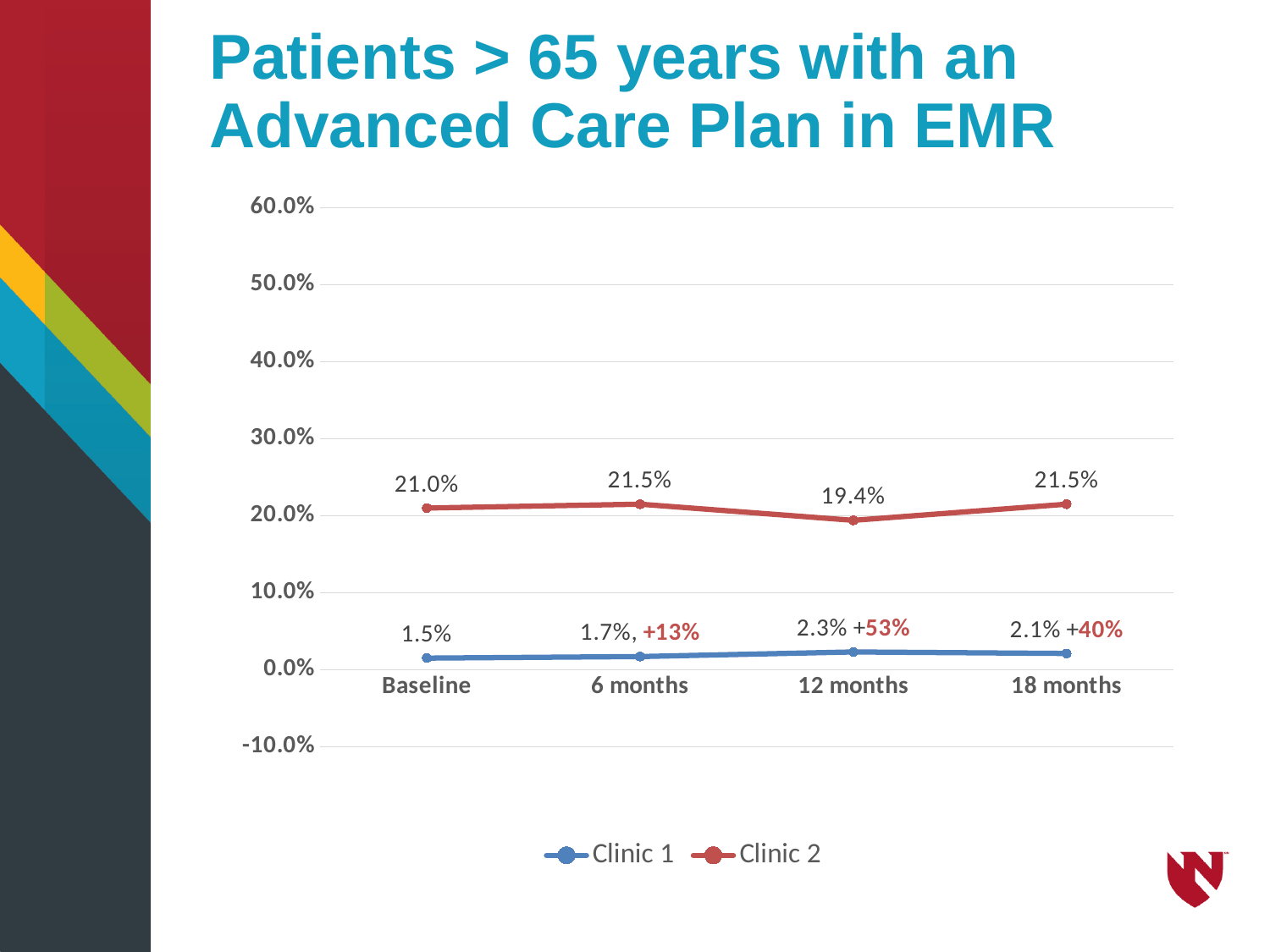
What is the value for Clinic 1 at 18 months? 2.1% What is the value for Clinic 1 at 12 months? 2.3% What is the value for Clinic 2 at 12 months? 19.4% How many time points are shown on the x axis? 4 At which time point is Clinic 2 lowest? 12 months Which is larger at 6 months, Clinic 1 or Clinic 2? Clinic 2 What is the value for Clinic 2 at Baseline? 21.0% At which time point is Clinic 1 highest? 12 months Is the value for Clinic 2 at 18 months greater or less than 30.0%? less How many series does the legend list? 2 What is the difference between Clinic 2 and Clinic 1 at Baseline? 19.5% What kind of chart is this? line chart